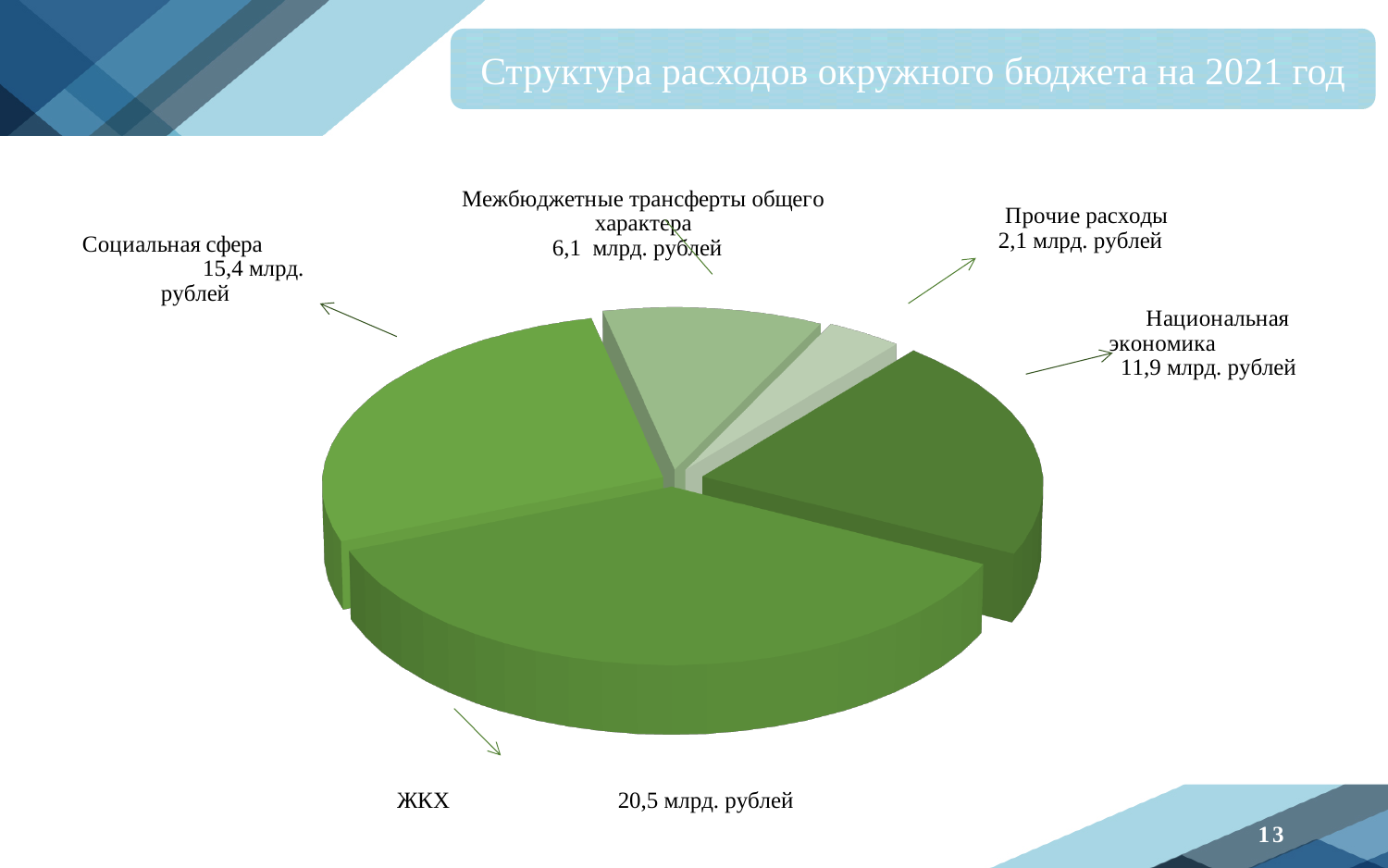
Which is larger: Социальная сфера or Национальная экономика? Социальная сфера What is the title of the chart on the slide? Структура расходов окружного бюджета на 2021 год How many categories (slices) does the pie chart have? 5 What type of chart is shown on the slide? Pie chart What is the value for Социальная сфера? 15,4 млрд. рублей What is the value for Национальная экономика? 11,9 млрд. рублей What is the value for ЖКХ? 20,5 млрд. рублей What is the value for Прочие расходы? 2,1 млрд. рублей What is the value for Межбюджетные трансферты общего характера? 6,1 млрд. рублей Which category has the smallest share of expenditures? Прочие расходы What is the difference between ЖКХ and Социальная сфера? 5,1 млрд. рублей Which category has the largest share of expenditures? ЖКХ